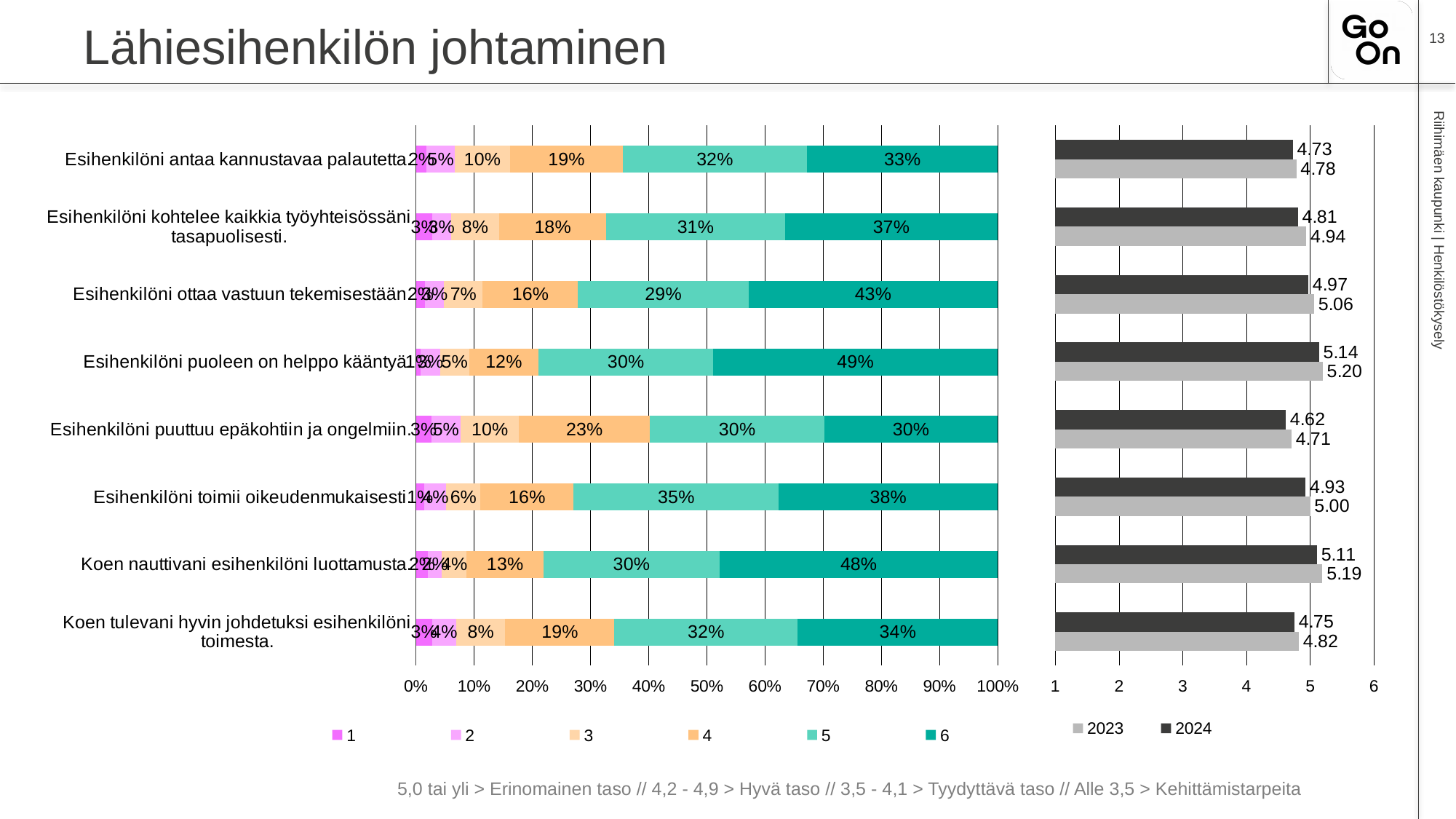
In the left stacked bar chart, what percentage of respondents gave a rating of 6 for "Esihenkilöni puoleen on helppo kääntyä"? 49% In the left stacked bar chart, how many series does the legend list? 6 In the right chart, what is the 2023 value for "Esihenkilöni puoleen on helppo kääntyä"? 5.20 In the right chart, which statement has the lowest 2024 value? Esihenkilöni puuttuu epäkohtiin ja ongelmiin In the left stacked bar chart, which statement has the highest share of rating 6? Esihenkilöni puoleen on helppo kääntyä In the right chart, what is the 2024 value for "Esihenkilöni puuttuu epäkohtiin ja ongelmiin"? 4.62 In the left stacked bar chart, what percentage gave a rating of 4 for "Esihenkilöni puuttuu epäkohtiin ja ongelmiin"? 23% In the left stacked bar chart, how many statements (categories) are shown? 8 What type of chart is the chart on the right side of the slide? bar chart In the right chart, what is the difference between the 2023 and 2024 values for "Esihenkilöni kohtelee kaikkia työyhteisössäni tasapuolisesti"? 0.13 In the left stacked bar chart, what is the difference between the rating-5 share and the rating-6 share for "Esihenkilöni ottaa vastuun tekemisestään"? 14% In the right chart, is the 2024 value for "Koen nauttivani esihenkilöni luottamusta" higher or lower than its 2023 value? lower